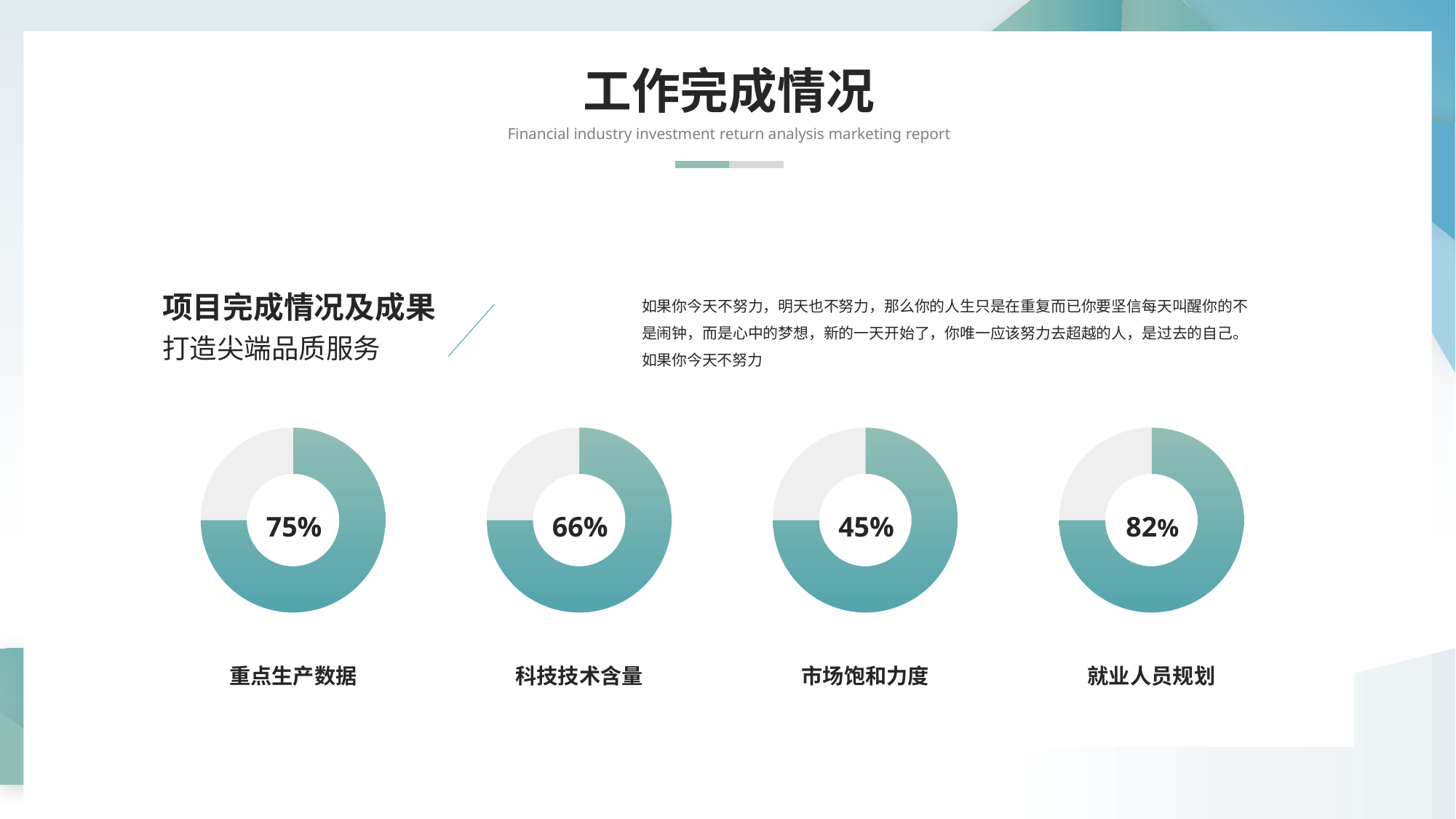
How many donut charts are shown on the slide? 4 What percentage is shown in the donut chart labelled 科技技术含量? 66% Which is larger, the percentage for 重点生产数据 or the percentage for 科技技术含量? 重点生产数据 What is the difference between the percentage for 重点生产数据 and the percentage for 科技技术含量? 9% What percentage is shown in the donut chart labelled 重点生产数据? 75% Among the four donut charts, which label has the highest percentage? 就业人员规划 What is the difference between the percentage for 就业人员规划 and the percentage for 市场饱和力度? 37% What percentage is shown in the donut chart labelled 就业人员规划? 82% What kind of chart is used to display the four percentages on the slide? Donut chart Among the four donut charts, which label has the lowest percentage? 市场饱和力度 What percentage is shown in the donut chart labelled 市场饱和力度? 45% In the donut chart labelled 市场饱和力度, is the filled (teal) portion more or less than half of the ring? more